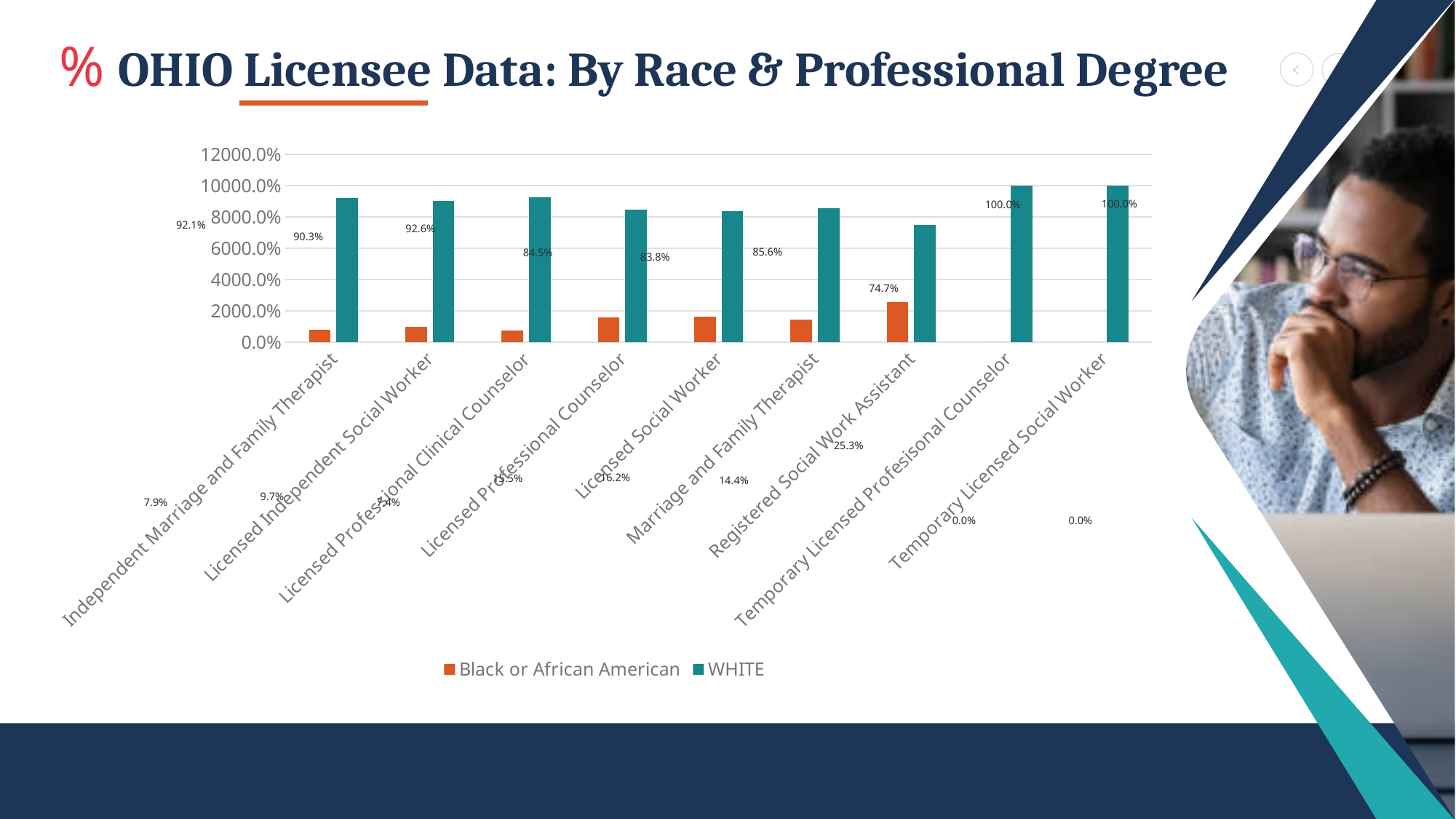
What is the difference between the WHITE and Black or African American values for Registered Social Work Assistant? 49.4% Which is larger for Licensed Social Worker: the WHITE value or the Black or African American value? WHITE What is the Black or African American value for Registered Social Work Assistant? 25.3% Which category has the highest Black or African American value? Registered Social Work Assistant How many series does the legend list? 2 Is the WHITE bar for Licensed Professional Counselor greater or less than 8000.0%? greater What is the WHITE value for Registered Social Work Assistant? 74.7% What type of chart is shown on the slide? bar chart What is the WHITE value for Temporary Licensed Social Worker? 100.0% Which category has the lowest WHITE value? Registered Social Work Assistant How many professional degree categories are shown on the x axis? 9 Which series is shown in orange in the legend? Black or African American